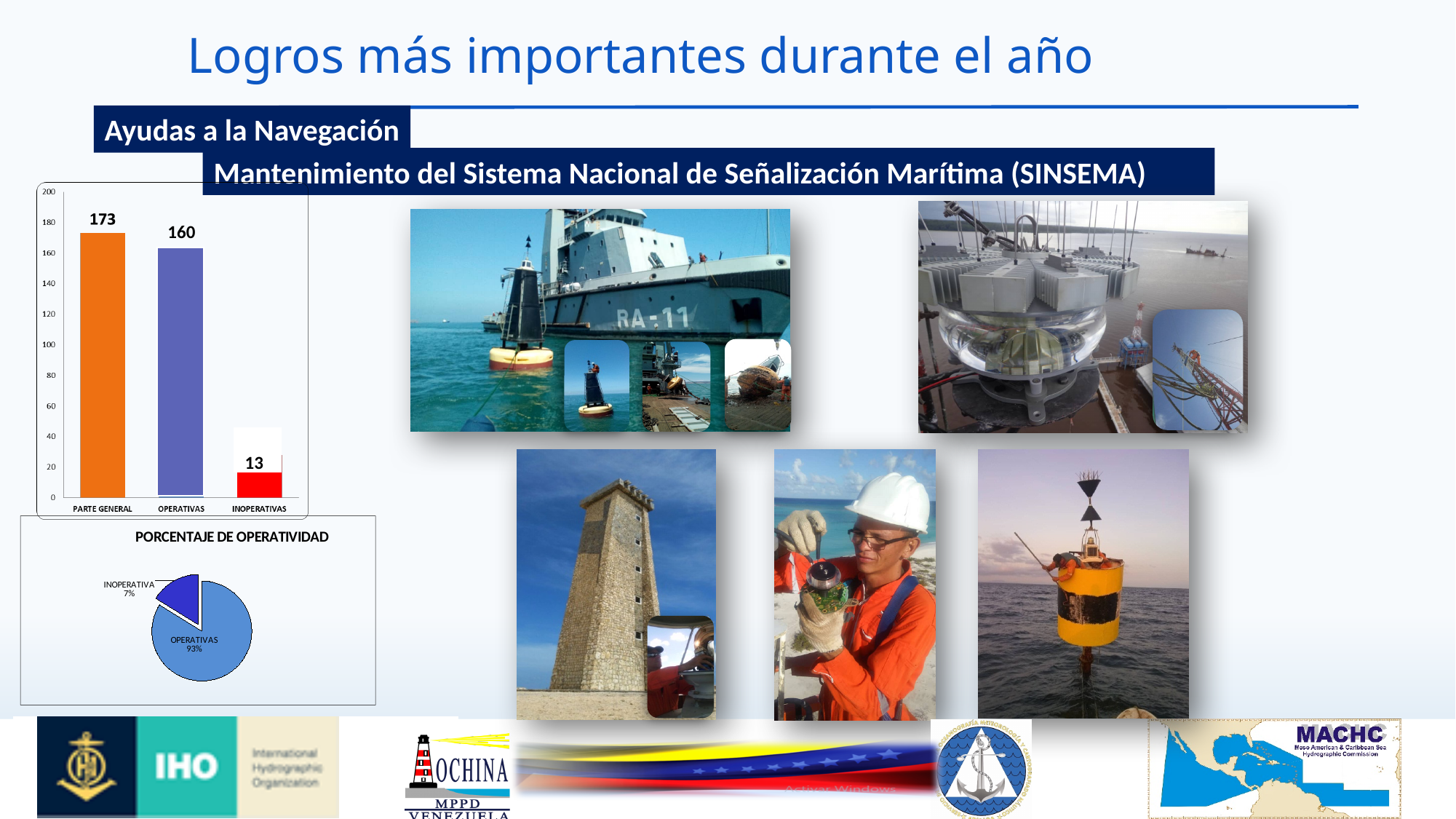
In the bar chart at the top left of the slide, which category has the highest value? PARTE GENERAL In the chart titled PORCENTAJE DE OPERATIVIDAD, what share does INOPERATIVA have? 7% What kind of chart is the chart titled PORCENTAJE DE OPERATIVIDAD? Pie chart In the bar chart at the top left of the slide, what is the difference between PARTE GENERAL and OPERATIVAS? 13 In the bar chart at the top left of the slide, what is the value for OPERATIVAS? 160 In the bar chart at the top left of the slide, what is the value for INOPERATIVAS? 13 What kind of chart is the chart at the top left of the slide? Bar chart In the bar chart at the top left of the slide, which is larger, OPERATIVAS or INOPERATIVAS? OPERATIVAS In the bar chart at the top left of the slide, which category has the lowest value? INOPERATIVAS How many categories are shown in the bar chart at the top left of the slide? 3 In the chart titled PORCENTAJE DE OPERATIVIDAD, what share does OPERATIVAS have? 93% In the bar chart at the top left of the slide, what is the value for PARTE GENERAL? 173